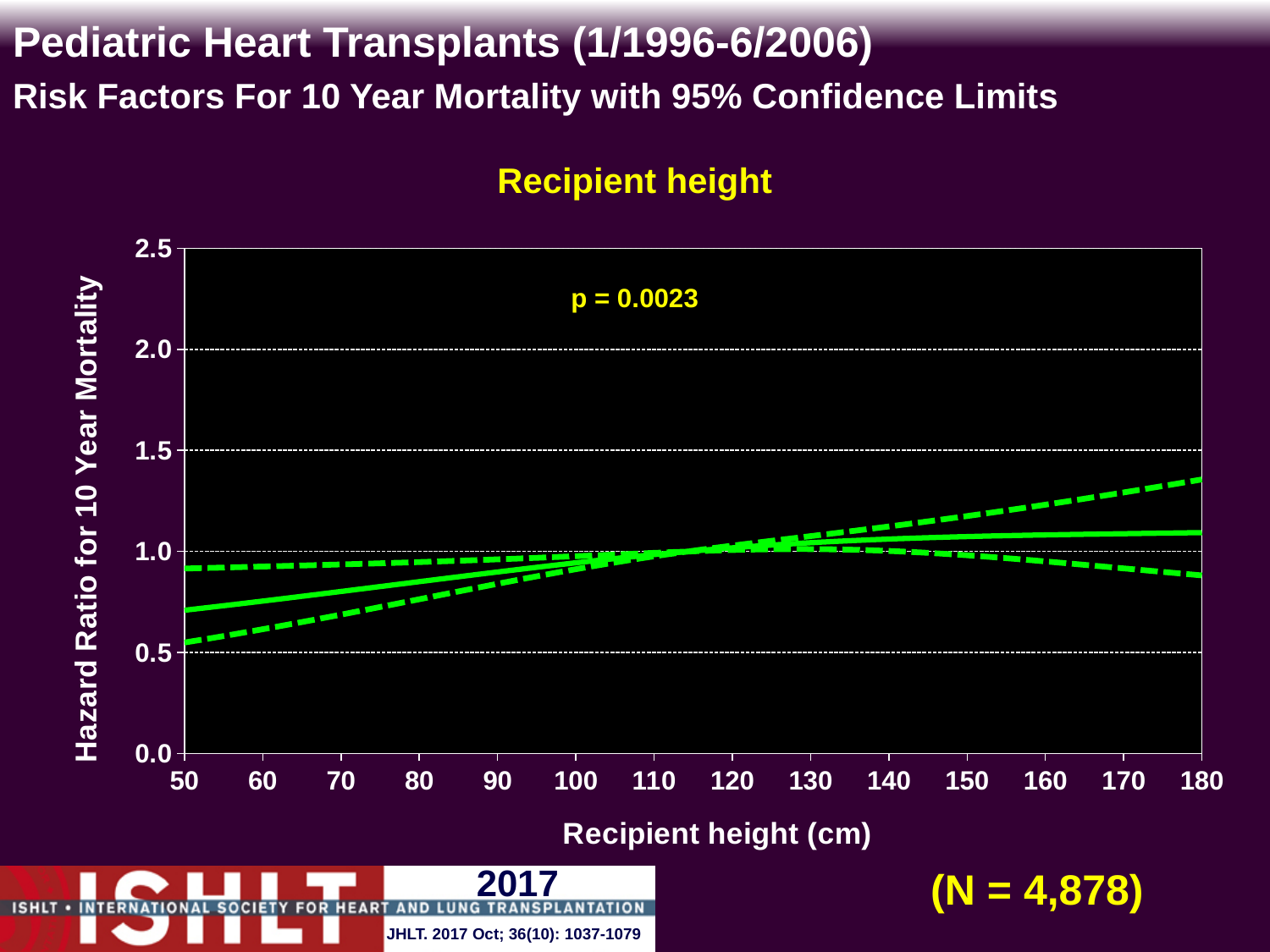
Does the solid hazard ratio line rise or fall as recipient height increases from 50 cm to 180 cm? rise Is the hazard ratio (solid line) at a recipient height of 180 cm greater or less than 1.0? greater Which is larger: the hazard ratio (solid line) at 50 cm or at 180 cm? 180 cm Is the hazard ratio (solid line) at a recipient height of 180 cm greater or less than 1.5? less Is the upper 95% confidence limit at a recipient height of 180 cm greater or less than 1.5? less How many lines are plotted on the chart? 3 What p-value is printed on the chart? p = 0.0023 What is the label of the x axis? Recipient height (cm) What kind of chart is shown on the slide? line chart